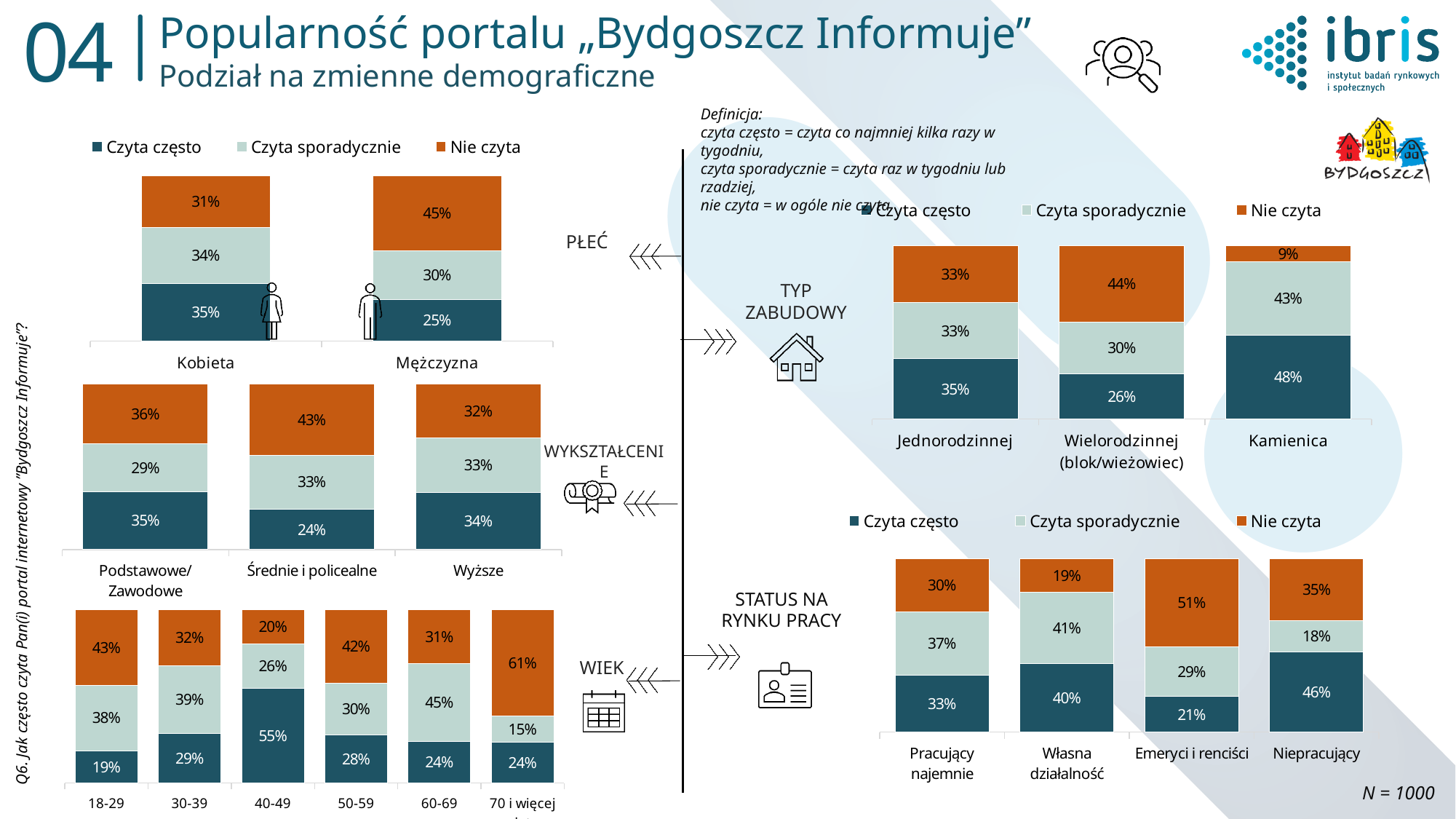
What type of chart is the WIEK chart? Stacked bar chart In the TYP ZABUDOWY chart, what is the Czyta sporadycznie value for Kamienica? 43% How many categories are shown in the STATUS NA RYNKU PRACY chart? 4 In the STATUS NA RYNKU PRACY chart, which has the larger Czyta często value: Własna działalność or Niepracujący? Niepracujący In the STATUS NA RYNKU PRACY chart, what is the Nie czyta value for Emeryci i renciści? 51% In the PŁEĆ chart, how many percentage points higher is the Czyta często value for Kobieta than for Mężczyzna? 10 percentage points In the TYP ZABUDOWY chart, which housing type has the lowest Nie czyta value? Kamienica In the PŁEĆ chart, what percentage of Mężczyzna is labelled Nie czyta? 45% In the WIEK chart, which age group has the highest Czyta często value? 40-49 In the WIEK chart, which age group has the highest Nie czyta value? 70 i więcej How many series does the legend of the WIEK chart list? 3 In the WYKSZTAŁCENIE chart, what is the Czyta często value for Średnie i policealne? 24%